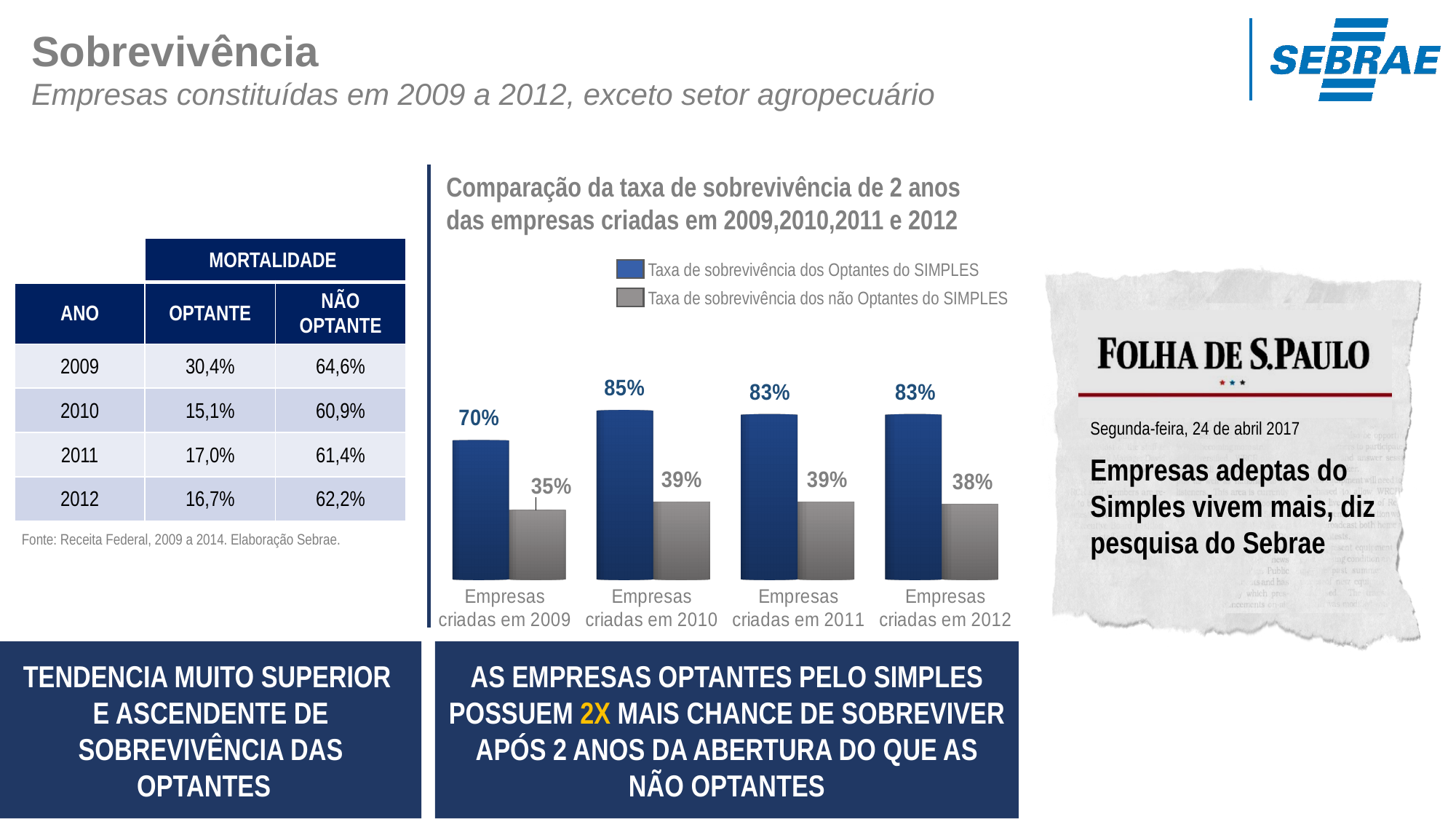
What kind of chart is shown on the slide? Bar chart How many series does the chart legend list? 2 What colour are the bars for the survival rate of SIMPLES optantes? Blue What is the difference between the optantes survival rate for companies created in 2010 and for companies created in 2009? 15% Which is larger: the optantes survival rate for companies created in 2009 or the non-optantes survival rate for companies created in 2012? Optantes survival rate for companies created in 2009 Which category has the lowest survival rate for non-optantes of SIMPLES? Empresas criadas em 2009 How many categories are shown on the x axis of the chart? 4 What is the difference between the optantes and non-optantes survival rates for companies created in 2011? 44% Which category has the highest survival rate for SIMPLES optantes? Empresas criadas em 2010 What is the survival rate of SIMPLES optantes for companies created in 2009? 70% What is the survival rate of SIMPLES optantes for companies created in 2012? 83% What is the survival rate of non-optantes of SIMPLES for companies created in 2010? 39%